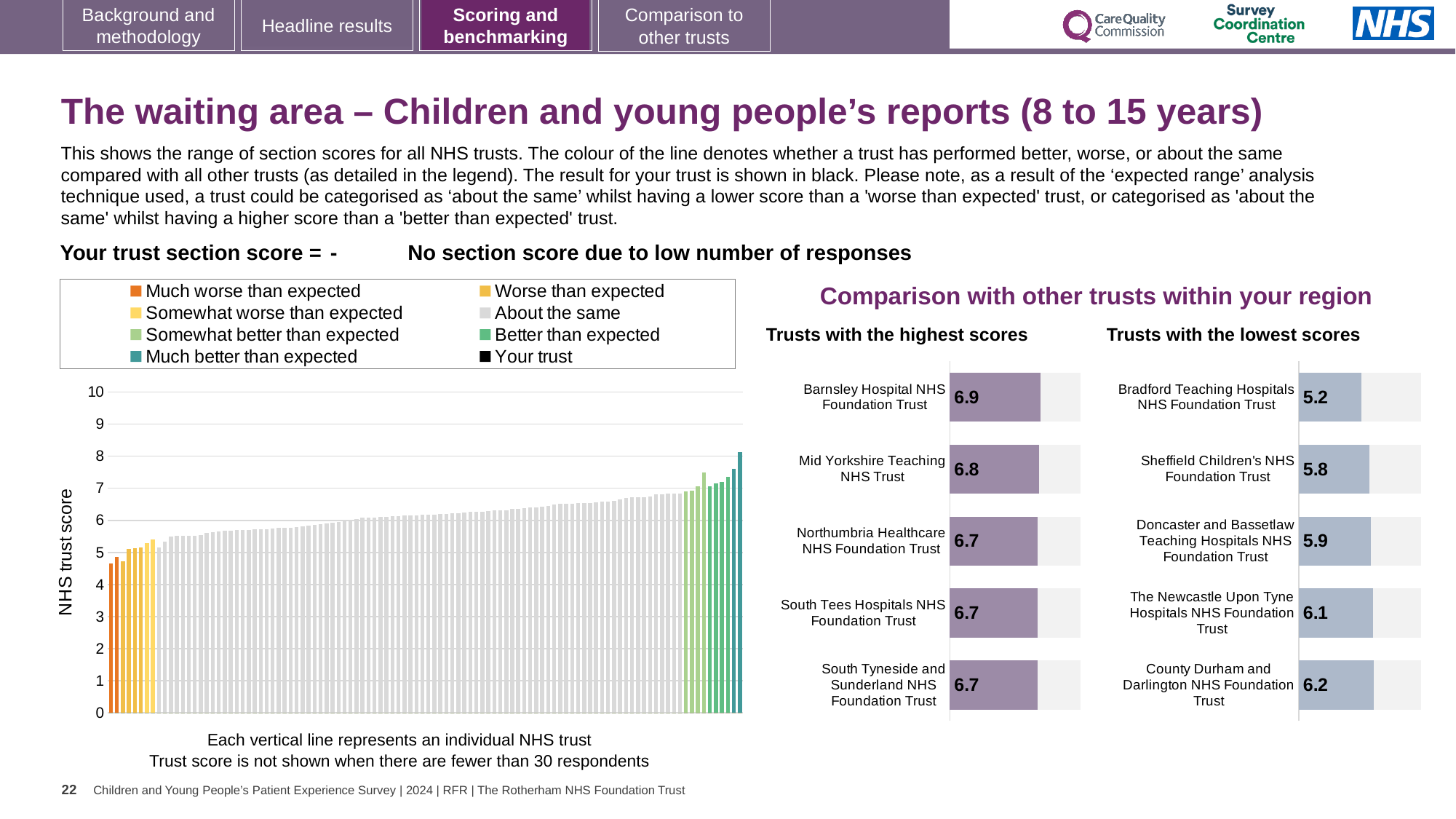
In the main chart on the left showing the range of section scores for all NHS trusts, do the bar values rise or fall from left to right? rise Which has a higher score: Sheffield Children's NHS Foundation Trust in the lowest scores chart or Northumbria Healthcare NHS Foundation Trust in the highest scores chart? Northumbria Healthcare NHS Foundation Trust In the 'Trusts with the lowest scores' chart, what is the difference between the scores of County Durham and Darlington NHS Foundation Trust and Bradford Teaching Hospitals NHS Foundation Trust? 1.0 In the 'Trusts with the highest scores' chart, what is the score for Mid Yorkshire Teaching NHS Trust? 6.8 In the 'Trusts with the lowest scores' chart, which trust has the highest score? County Durham and Darlington NHS Foundation Trust In the 'Trusts with the lowest scores' chart, which trust has the lowest score? Bradford Teaching Hospitals NHS Foundation Trust How many entries does the legend of the main chart on the left list? 8 In the 'Trusts with the highest scores' chart, what is the difference between the scores of Barnsley Hospital NHS Foundation Trust and Mid Yorkshire Teaching NHS Trust? 0.1 In the 'Trusts with the lowest scores' chart, what is the score for Bradford Teaching Hospitals NHS Foundation Trust? 5.2 How many trusts are listed in the 'Trusts with the highest scores' chart? 5 In the main chart on the left showing the range of section scores for all NHS trusts, is the value of the lowest bar greater or less than 5? less In the 'Trusts with the highest scores' chart, what is the score for Barnsley Hospital NHS Foundation Trust? 6.9